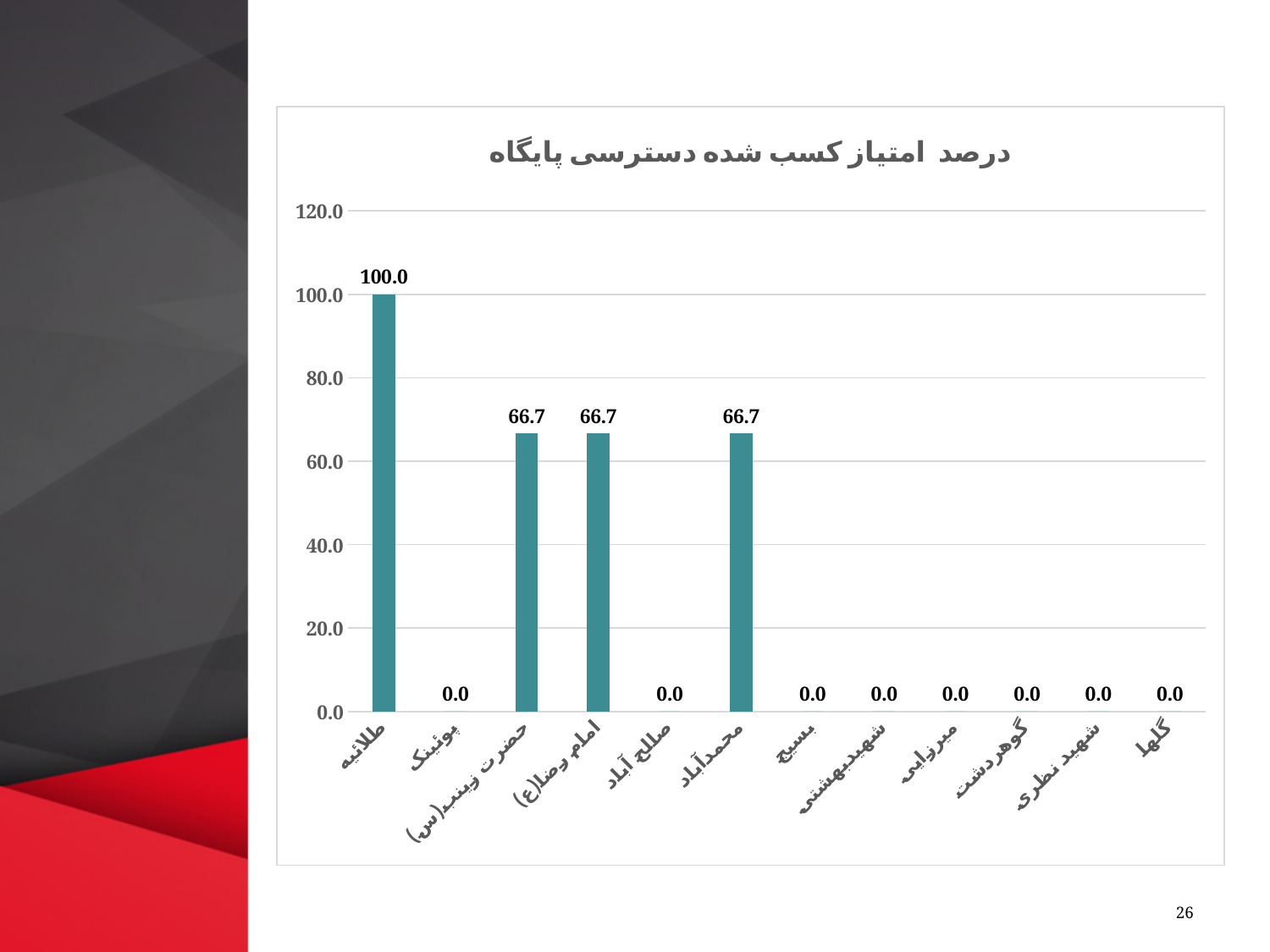
Which category has the highest value? طلائیه What is the value for محمدآباد? 66.7 How many categories are shown on the x axis? 12 What kind of chart is shown? bar chart What is the title of the chart? درصد امتیاز کسب شده دسترسی پایگاه What is the value for گوهردشت? 0.0 What is the value for حضرت زینب(س)? 66.7 Is the value for امام رضا(ع) greater or less than 60.0? greater How many categories have a value of 0.0? 8 What is the difference between the values for طلائیه and امام رضا(ع)? 33.3 Which is larger, the value for حضرت زینب(س) or the value for صالح آباد? حضرت زینب(س) What is the value for طلائیه? 100.0